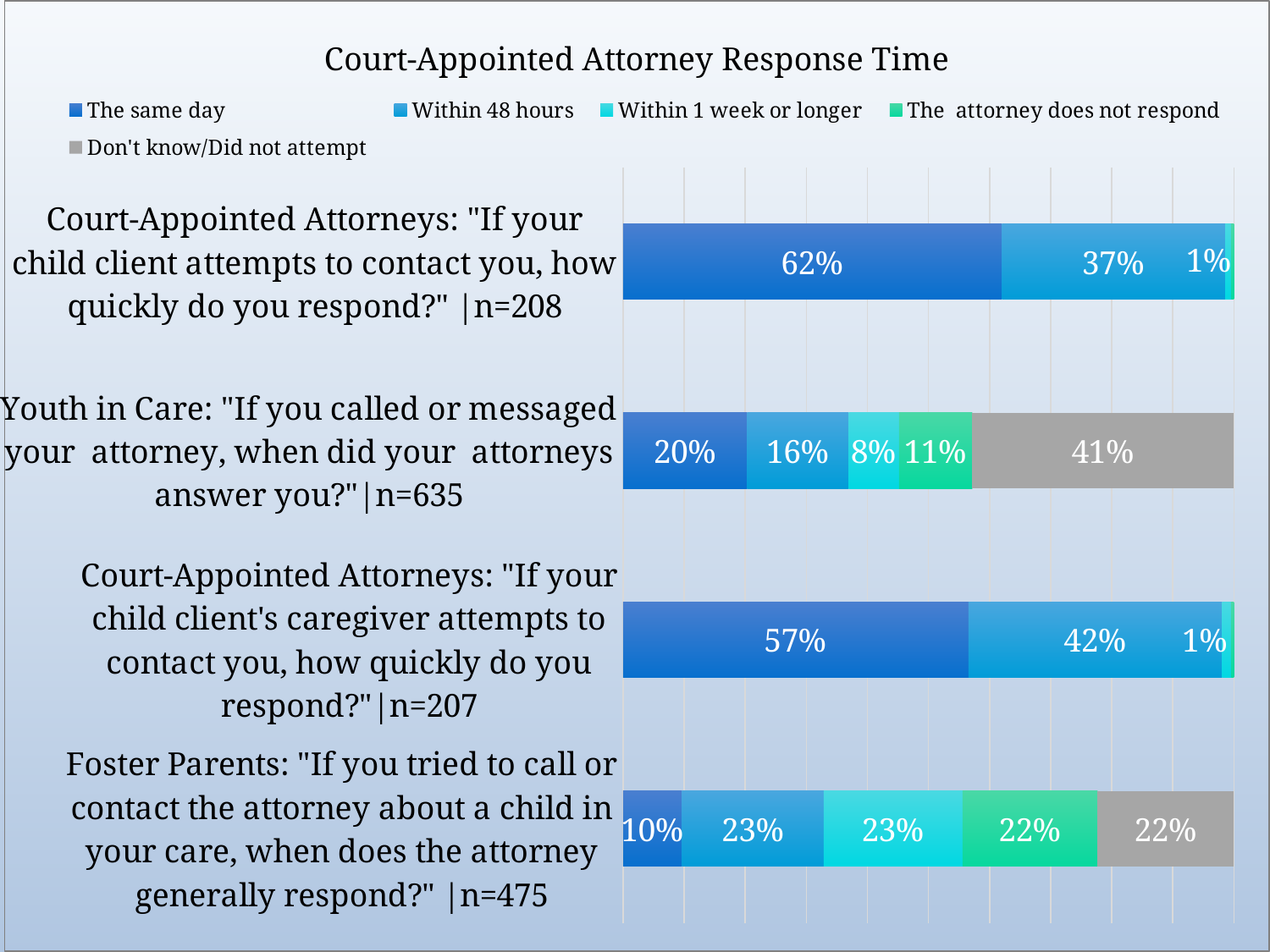
Which respondent group has the highest "The same day" value? Court-Appointed Attorneys: "If your child client attempts to contact you, how quickly do you respond?" (n=208) Which is larger: the "Within 1 week or longer" value for Youth in Care or for Foster Parents? Foster Parents What is the difference between the "Within 48 hours" values for Court-Appointed Attorneys responding to caregivers (n=207) and Youth in Care (n=635)? 26% What percentage of Court-Appointed Attorneys (n=207) said they respond to a caregiver within 48 hours? 42% How many series does the legend list? 5 What percentage of Foster Parents (n=475) said the attorney does not respond? 22% What is the title of the chart? Court-Appointed Attorney Response Time Which respondent group has the lowest "The same day" value? Foster Parents (n=475) What percentage of Court-Appointed Attorneys (n=208) said they respond to a child client the same day? 62% How many bars (respondent groups) are plotted in the chart? 4 What kind of chart is shown on the slide? Stacked bar chart What percentage of Youth in Care (n=635) answered "Don't know/Did not attempt"? 41%